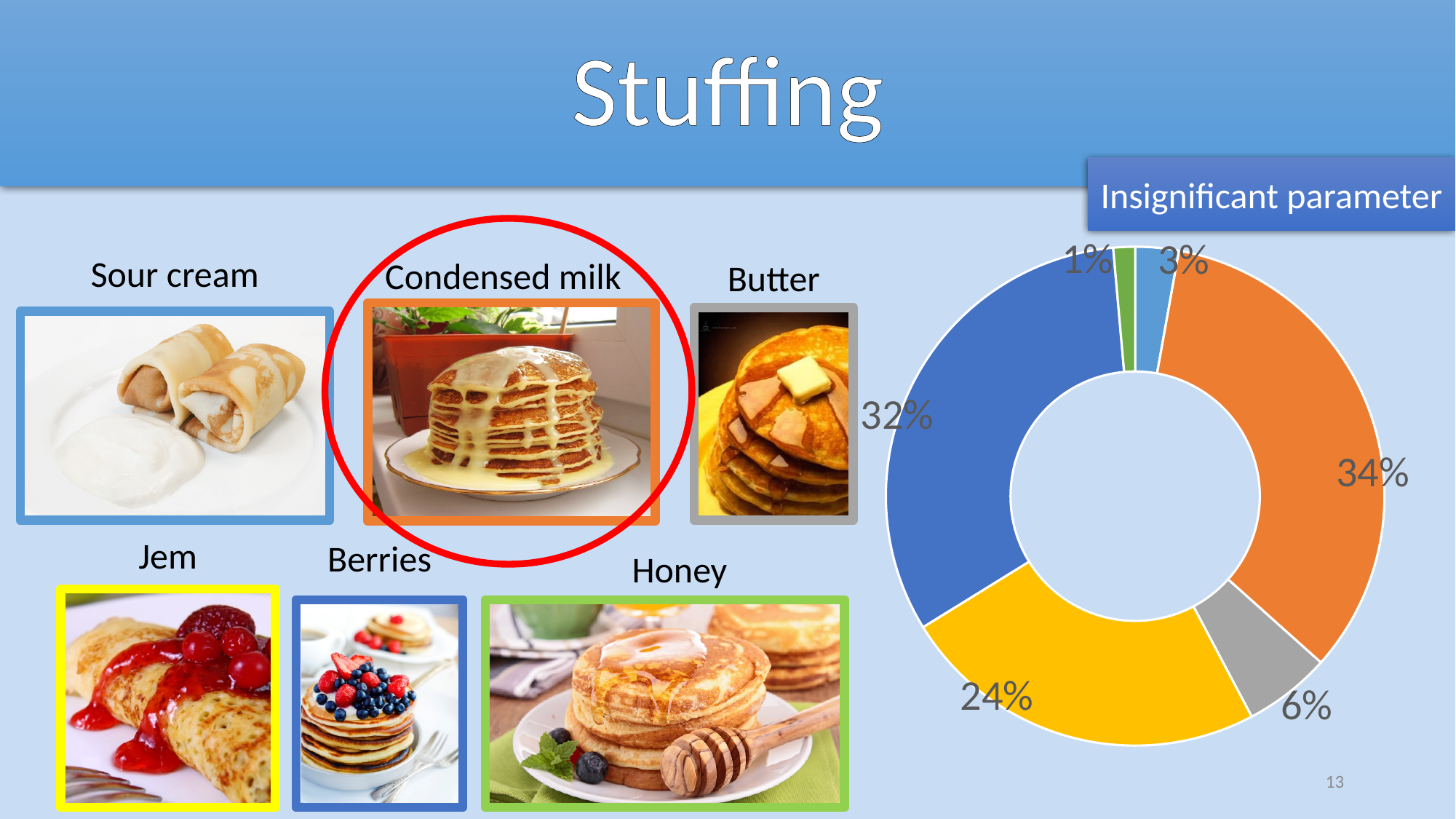
Which is larger, the yellow slice or the gray slice? The yellow slice What percentage is shown for the dark blue slice of the doughnut chart? 32% What percentage is shown for the gray slice of the doughnut chart? 6% Which slice of the doughnut chart has the smallest share? The green slice (1%) What percentage is shown for the green slice of the doughnut chart? 1% What is the difference in percentage points between the orange slice and the dark blue slice? 2 percentage points What does the label in the box above the doughnut chart say? Insignificant parameter What percentage is shown for the yellow slice of the doughnut chart? 24% What kind of chart is shown on the right of the slide? Doughnut (pie) chart How many slices does the doughnut chart have? 6 What percentage is shown for the orange slice of the doughnut chart? 34% Which slice of the doughnut chart has the largest share? The orange slice (34%)